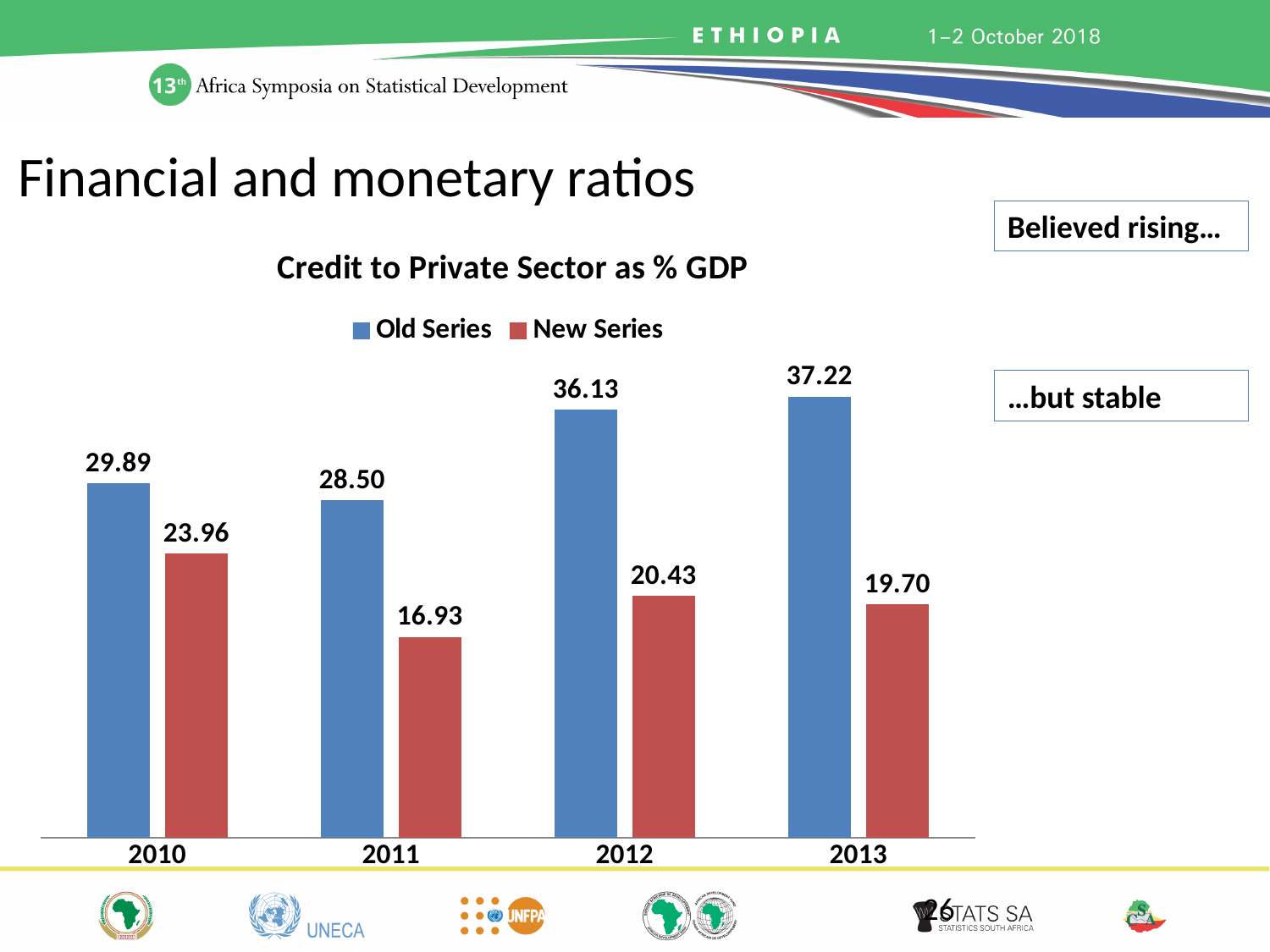
How many years are shown on the x axis? 4 What is the title of the chart? Credit to Private Sector as % GDP What kind of chart is shown? Bar chart Which year has the lowest New Series value? 2011 Which is larger, the New Series value for 2010 or for 2012? 2010 Which year has the highest Old Series value? 2013 What is the difference between the Old Series and New Series values in 2010? 5.93 What is the New Series value for 2013? 19.70 Does the Old Series rise or fall from 2011 to 2013? Rise How many series does the legend list? 2 What is the New Series value for 2011? 16.93 What is the Old Series value for 2012? 36.13